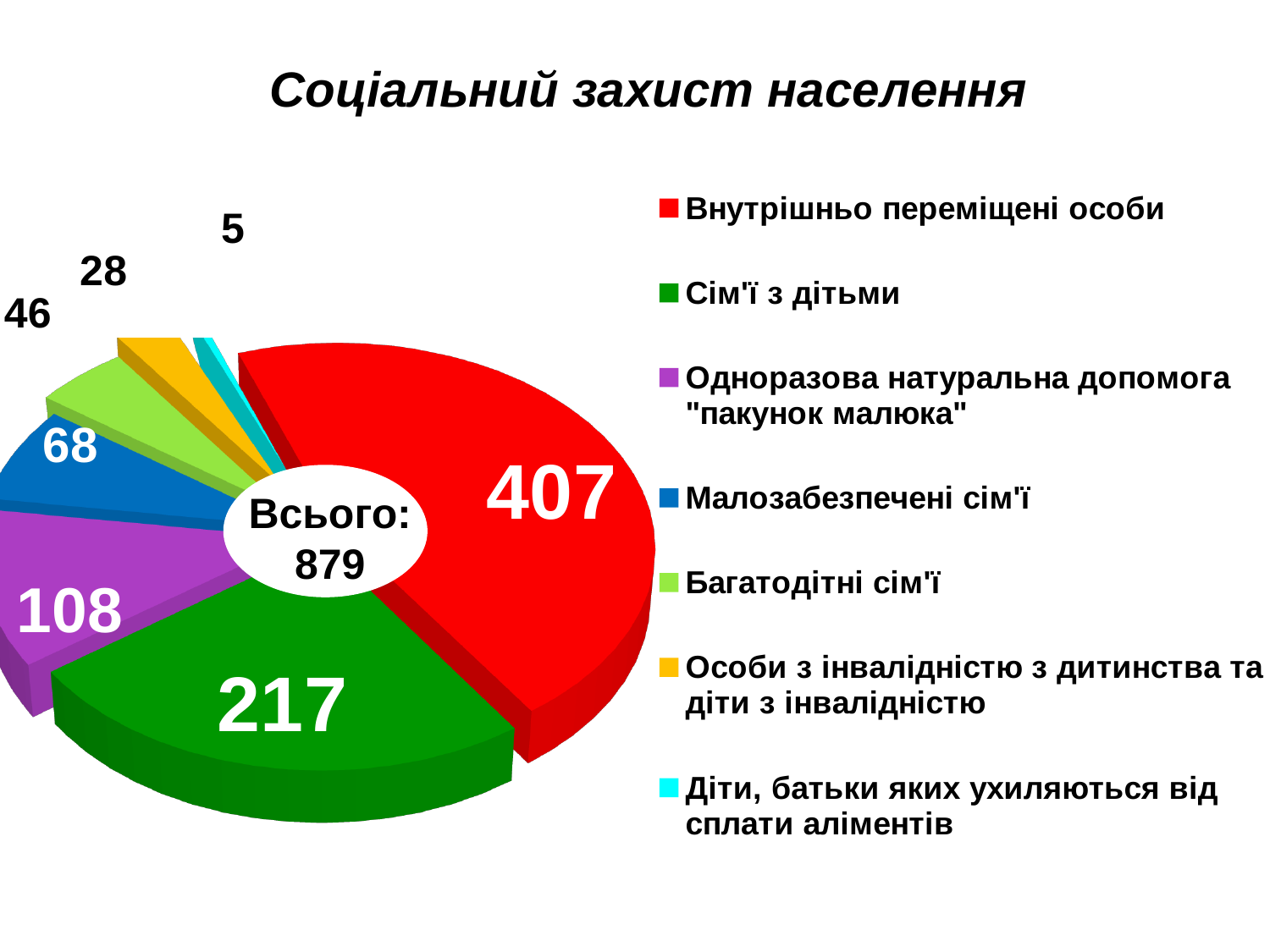
What is the title of the chart? Соціальний захист населення Which category has the largest slice of the pie? Внутрішньо переміщені особи Which is larger: Одноразова натуральна допомога "пакунок малюка" or Багатодітні сім'ї? Одноразова натуральна допомога "пакунок малюка" What total is printed in the centre of the pie chart? 879 Which category has the smallest slice of the pie? Діти, батьки яких ухиляються від сплати аліментів What is the difference between the values for Внутрішньо переміщені особи and Сім'ї з дітьми? 190 What is the value for Діти, батьки яких ухиляються від сплати аліментів? 5 How many categories does the pie chart show? 7 What is the value for Сім'ї з дітьми? 217 What is the value for Малозабезпечені сім'ї? 68 What is the value for Внутрішньо переміщені особи? 407 What kind of chart is shown on the slide? Pie chart